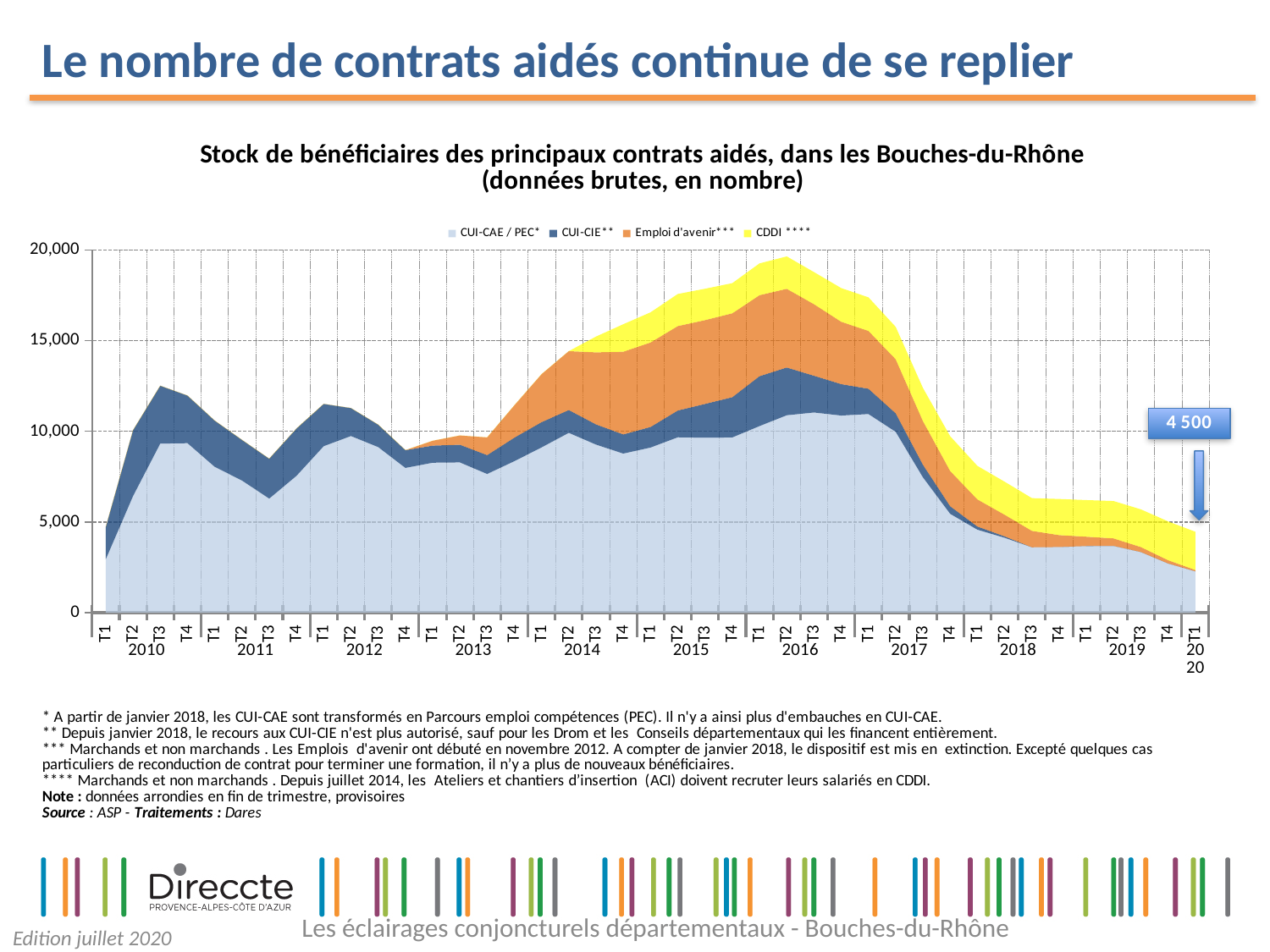
What kind of chart is shown on the slide? stacked area chart What total value is labelled on the chart for T1 2020? 4 500 Is the total stock of beneficiaries in T1 2018 greater or less than 10,000? less Is the total stock of beneficiaries in T2 2016 greater or less than 15,000? greater Is the total stock of beneficiaries in T3 2010 greater or less than 10,000? greater In which quarter does the total stock of beneficiaries reach its highest level? T2 2016 How many series does the legend list? 4 Does the total stock of beneficiaries rise or fall between T2 2016 and T1 2020? fall What is the title of the chart? Stock de bénéficiaires des principaux contrats aidés, dans les Bouches-du-Rhône (données brutes, en nombre) How many years are labelled along the x axis? 11 Which series is shown in yellow in the legend? CDDI ****